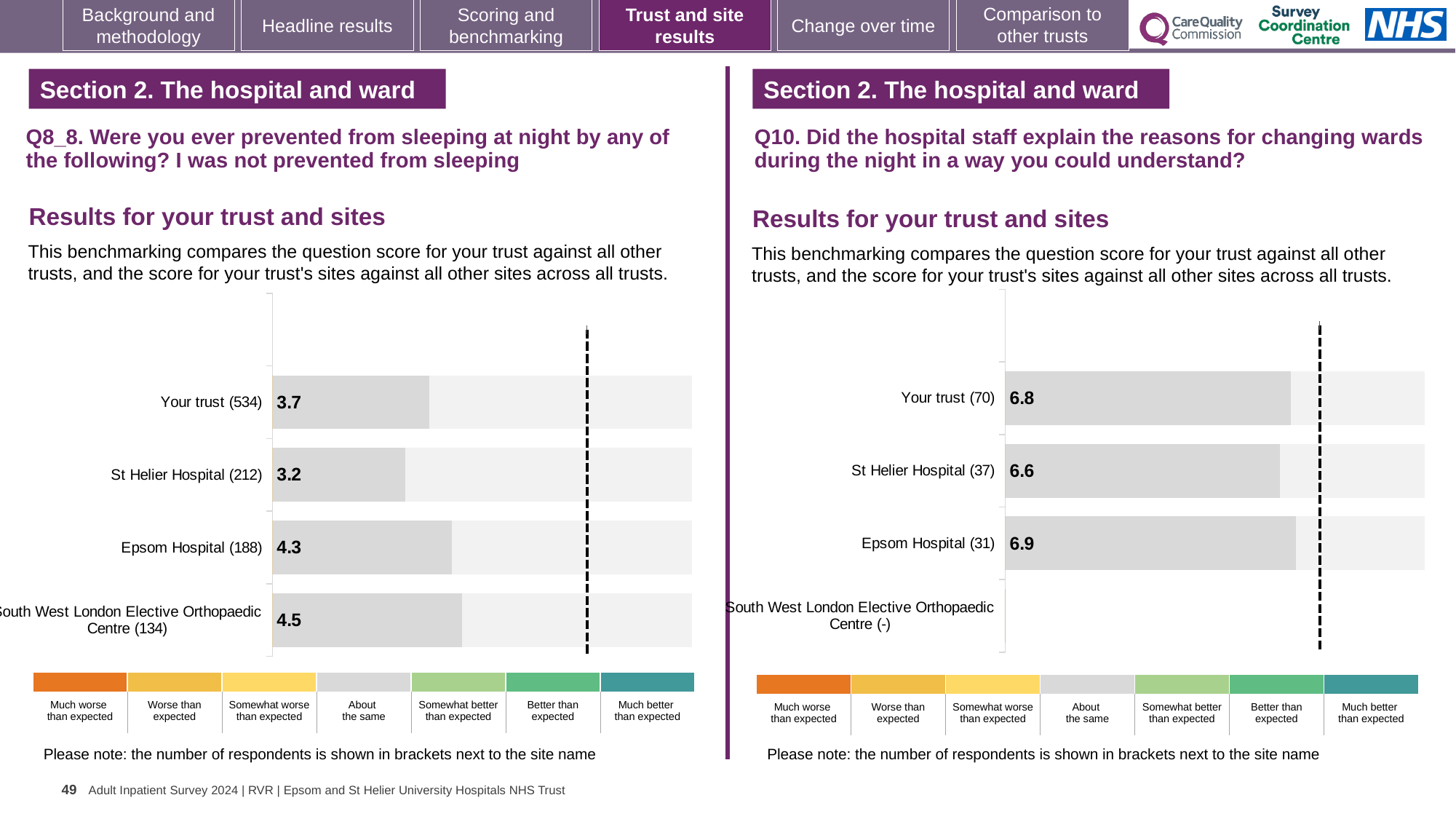
In the Q8_8 chart on the left, which has the larger score, Your trust or Epsom Hospital? Epsom Hospital In the Q10 chart on the right, which site with a printed score has the highest score? Epsom Hospital (31) In the Q10 chart on the right, what is the difference between the scores for Epsom Hospital and St Helier Hospital? 0.3 What type of chart is used in the Q10 chart on the right? Bar chart In the Q8_8 chart on the left, what is the score for Your trust (534)? 3.7 In the Q8_8 chart on the left, what is the difference between the scores for South West London Elective Orthopaedic Centre and St Helier Hospital? 1.3 In the Q10 chart on the right, what is the score for Your trust (70)? 6.8 In the Q10 chart on the right, what is the score for St Helier Hospital (37)? 6.6 How many rows (trust and sites) are shown in the Q8_8 chart on the left? 4 In the Q8_8 chart on the left, which site has the highest score? South West London Elective Orthopaedic Centre (134) In the Q8_8 chart on the left, what is the score for Epsom Hospital (188)? 4.3 In the Q8_8 chart on the left, which site has the lowest score? St Helier Hospital (212)